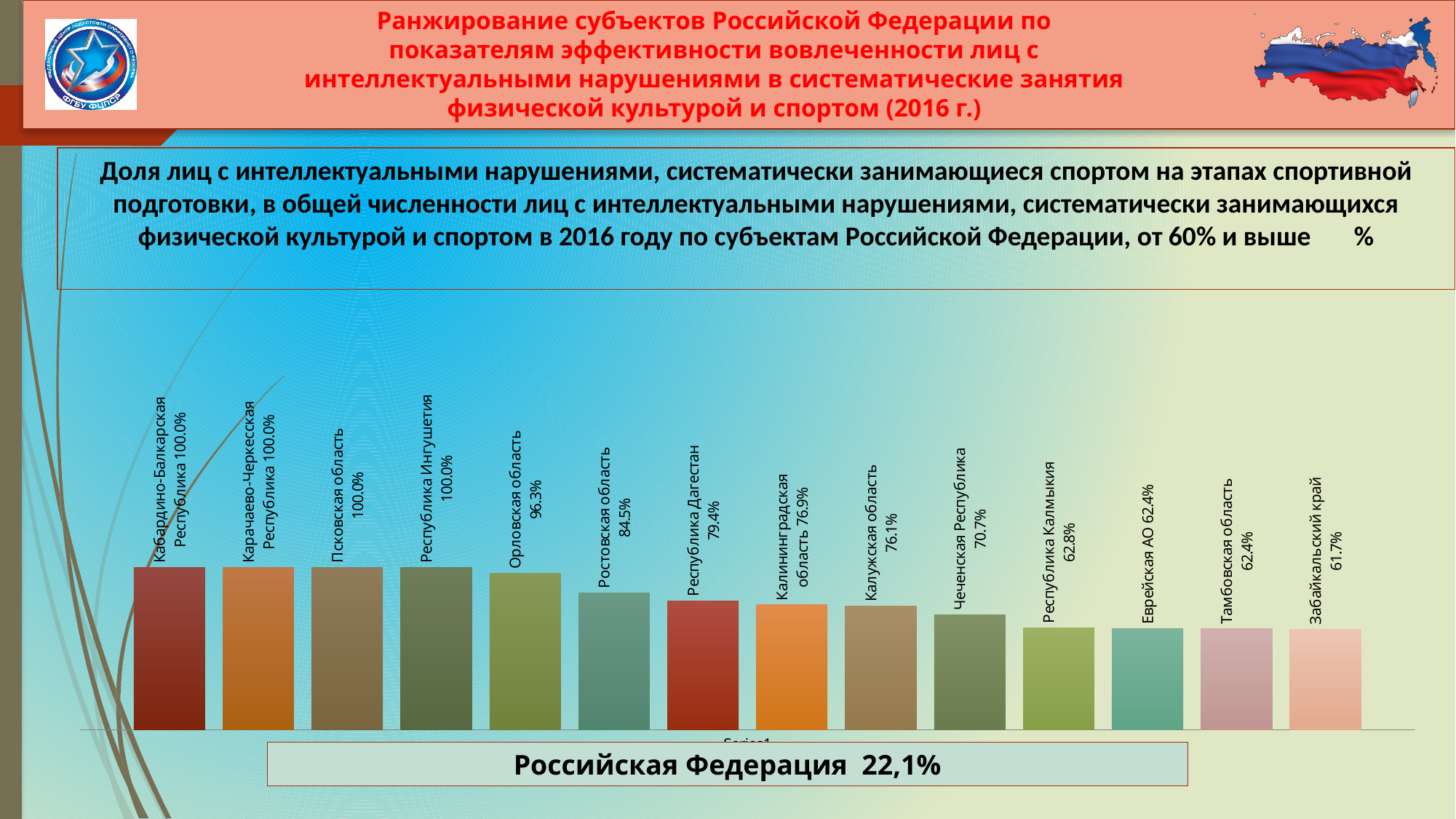
Do the values rise or fall from left to right across the chart? Fall Which region has the lowest value in the chart? Забайкальский край What kind of chart is shown on the slide? Bar chart How many regions are shown as bars in the chart? 14 Which is larger, the value for Калужская область or the value for Чеченская Республика? Калужская область What is the value for Чеченская Республика? 70.7% What is the value for Орловская область? 96.3% What is the difference between the values for Орловская область and Ростовская область? 11.8% What is the value for Республика Дагестан? 79.4% What is the difference between the values for Республика Дагестан and Калининградская область? 2.5% What is the value for Забайкальский край? 61.7% What is the value for Ростовская область? 84.5%